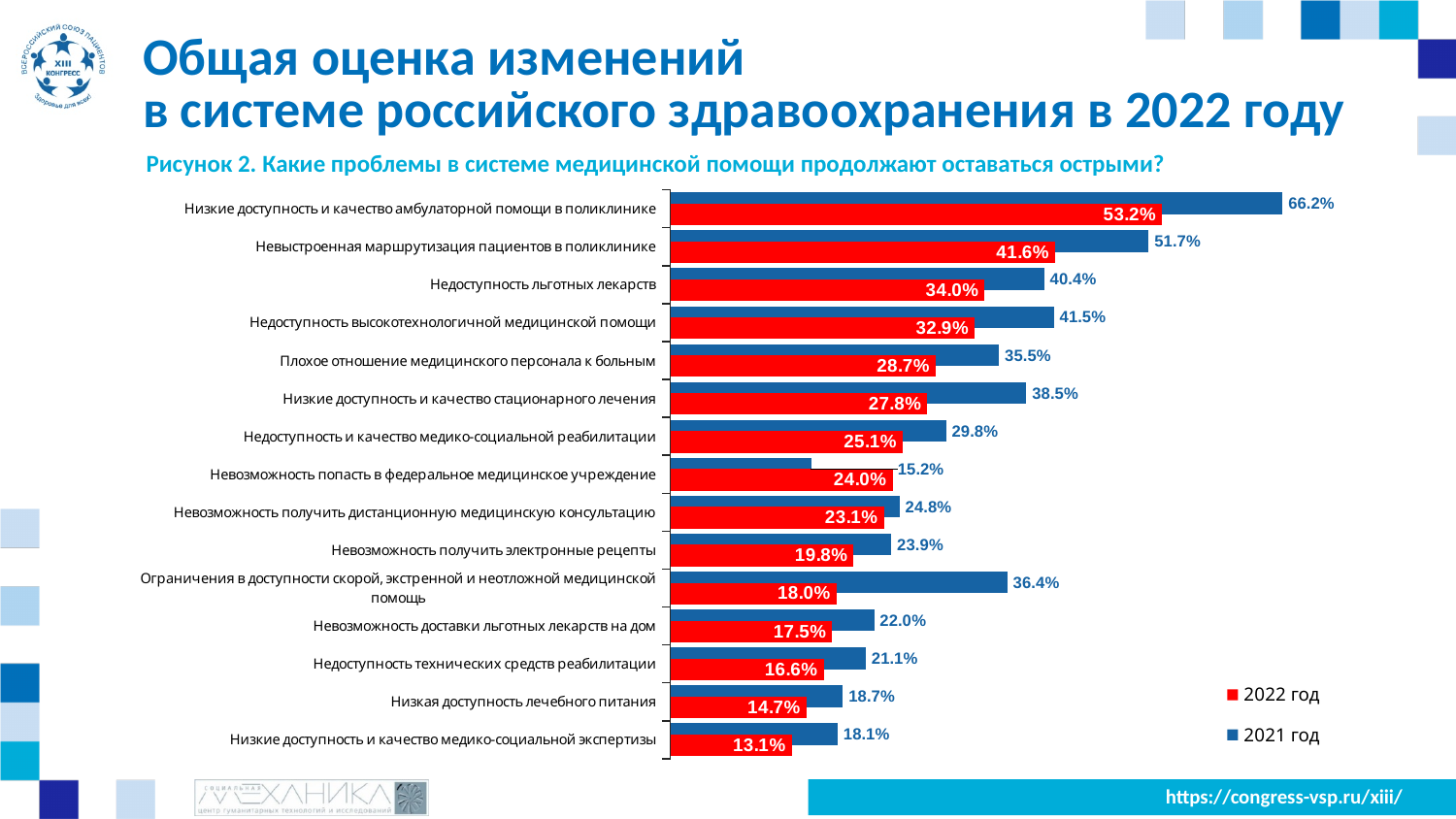
Which category has the lowest 2022 год value? Низкие доступность и качество медико-социальной экспертизы What type of chart is shown on the slide? Bar chart For «Невозможность попасть в федеральное медицинское учреждение», which year has the larger value, 2022 год or 2021 год? 2022 год How many series does the legend list? 2 What is the 2022 год value for «Невозможность попасть в федеральное медицинское учреждение»? 24.0% Which category has the highest 2021 год value? Низкие доступность и качество амбулаторной помощи в поликлинике What is the 2022 год value for «Недоступность льготных лекарств»? 34.0% What is the 2021 год value for «Ограничения в доступности скорой, экстренной и неотложной медицинской помощь»? 36.4% Which is larger: the 2022 год value for «Плохое отношение медицинского персонала к больным» or the 2022 год value for «Низкие доступность и качество стационарного лечения»? Плохое отношение медицинского персонала к больным Which colour represents the 2021 год series in the chart? Blue What is the difference between the 2021 год and 2022 год values for «Низкие доступность и качество амбулаторной помощи в поликлинике»? 13.0% How many categories (problems) are shown in the chart? 15